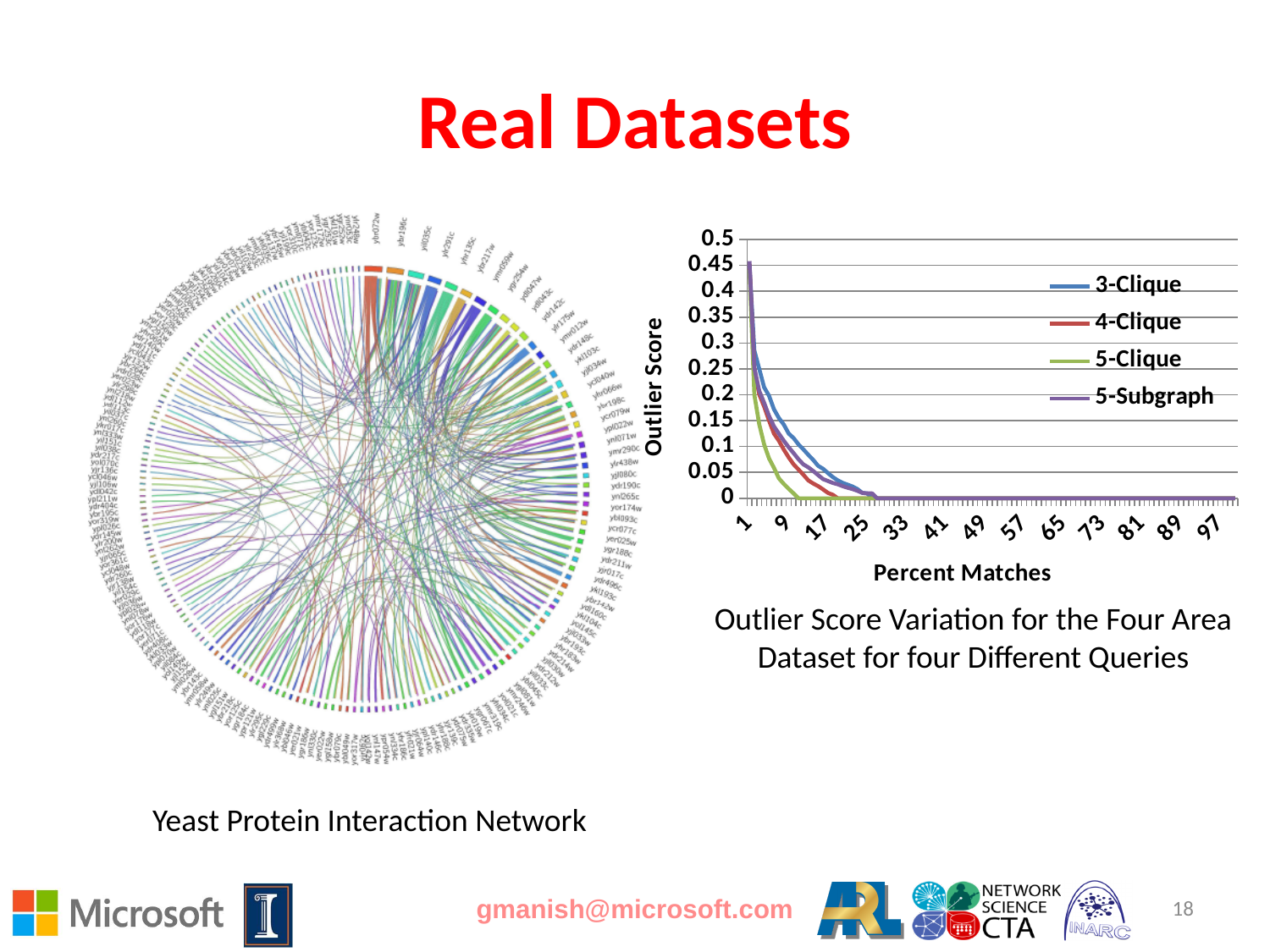
In the Outlier Score chart, at 9 percent matches, which series has the higher outlier score, 3-Clique or 5-Clique? 3-Clique In the Outlier Score chart, is the 3-Clique value at 9 percent matches greater or less than 0.1? greater In the Outlier Score chart, is the 4-Clique value at 41 percent matches greater or less than 0.05? less What is the highest tick value shown on the y-axis of the Outlier Score chart? 0.5 What is the label of the y-axis of the line chart? Outlier Score In the Outlier Score chart, do the values rise or fall as Percent Matches increases? fall How many series does the legend of the Outlier Score chart list? 4 What kind of chart is shown on the right side of the slide? line chart In the Outlier Score chart, is the 5-Clique value at 9 percent matches greater or less than 0.05? less In the Outlier Score chart, which series keeps the highest outlier score at 9 percent matches? 3-Clique What are the series names listed in the legend of the Outlier Score chart? 3-Clique, 4-Clique, 5-Clique, 5-Subgraph In the Outlier Score chart, which series reaches an outlier score of 0 at the smallest percent matches? 5-Clique